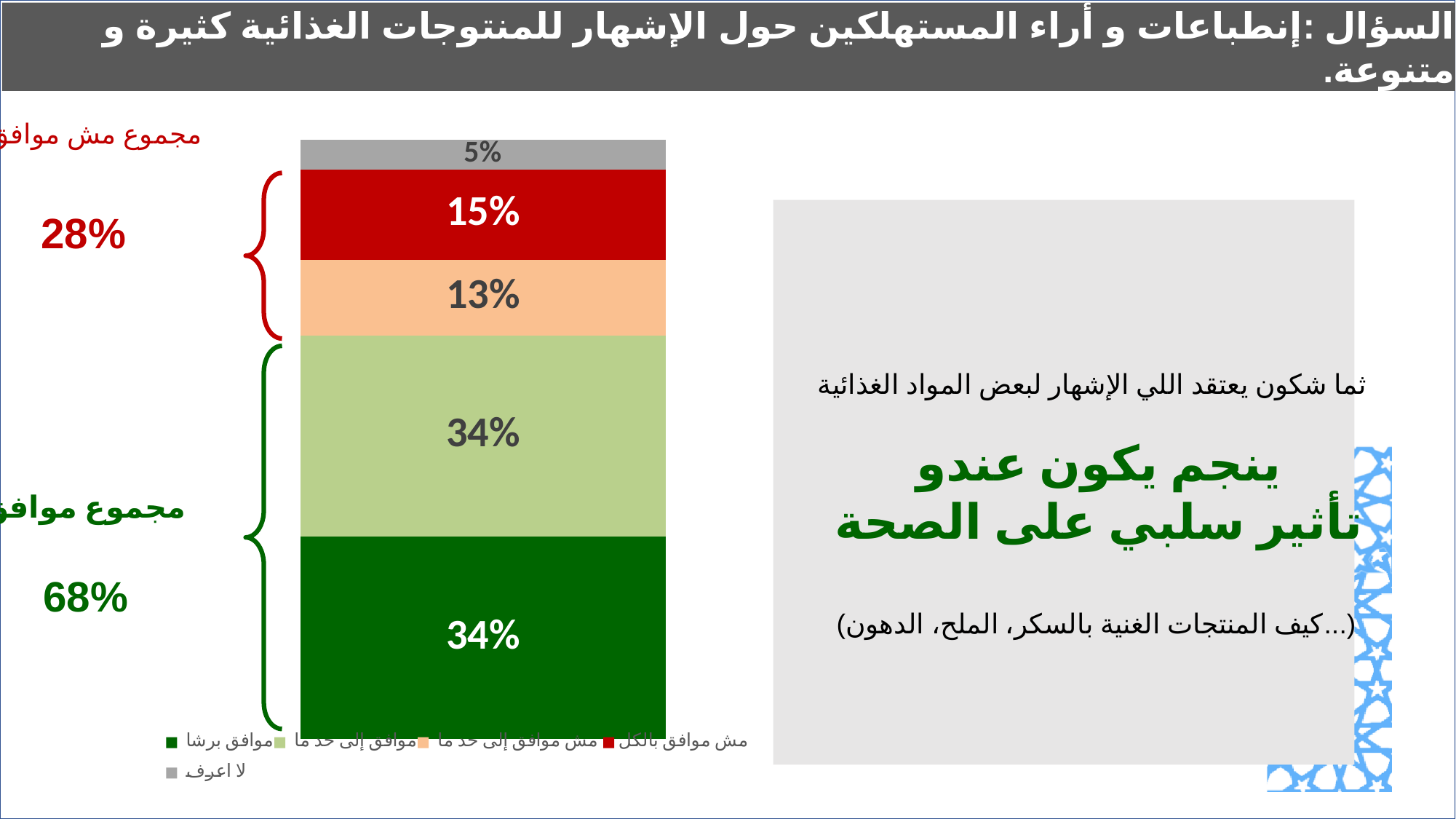
What is the value of the dark green segment (موافق برشا) in the stacked bar? 34% What is the value of the grey segment (لا اعرف) at the top of the stacked bar? 5% What is the combined total of the red and orange segments (مش موافق بالكل and مش موافق إلى حد ما)? 28% Which segment of the stacked bar has the smallest value? لا اعرف (5%) How many series does the legend list? 5 What is the value of the orange segment (مش موافق إلى حد ما) in the stacked bar? 13% What is the difference between the red segment (15%) and the orange segment (13%)? 2% Which is larger: the red segment (مش موافق بالكل) or the grey segment (لا اعرف)? مش موافق بالكل (15%) What label is shown next to the green bracket on the left of the chart? مجموع موافق What is the value of the red segment (مش موافق بالكل) in the stacked bar? 15% What kind of chart is shown on the slide? stacked bar chart What is the combined total of the two green segments (موافق برشا and موافق إلى حد ما)? 68%